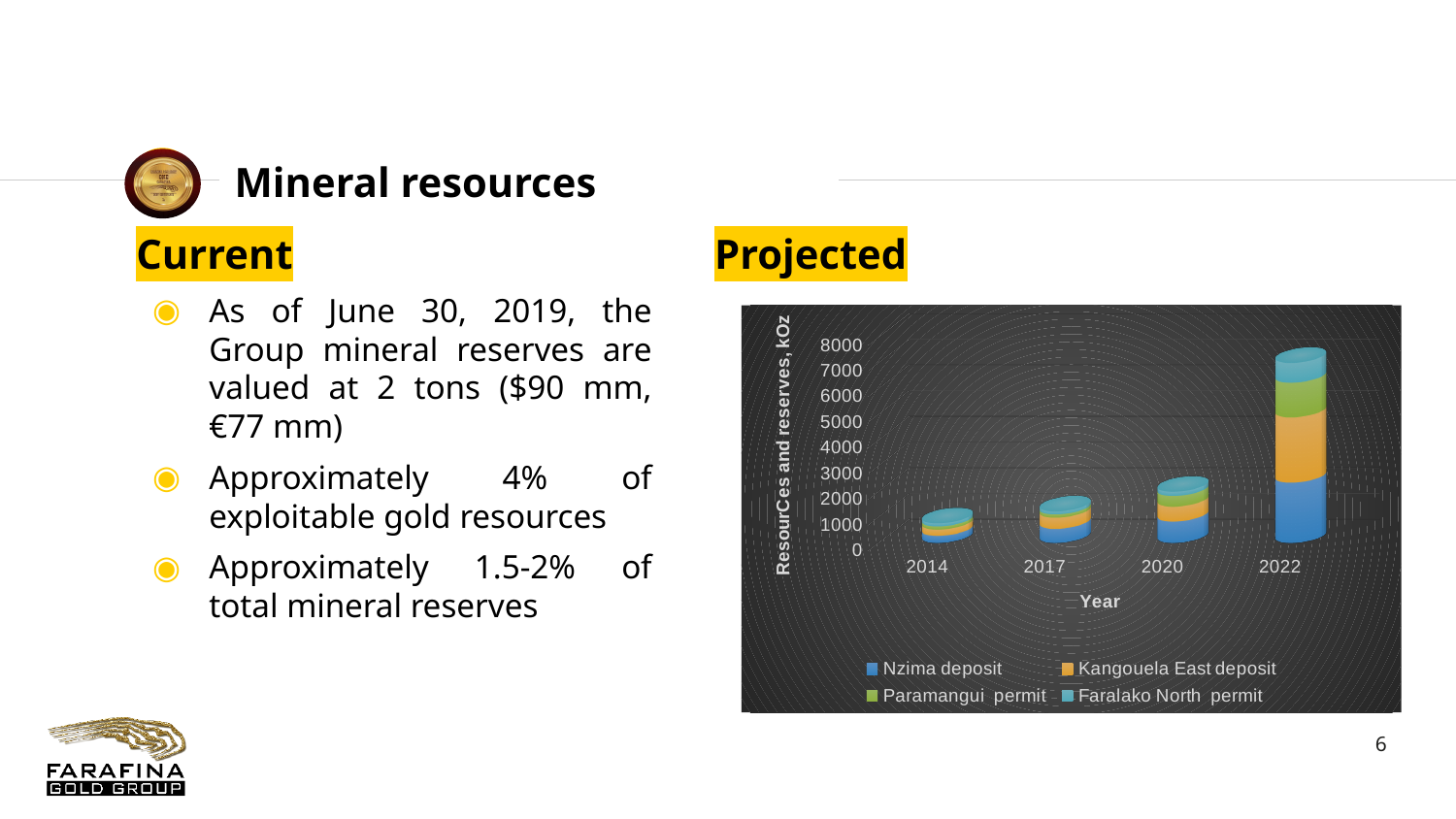
Which year has the shortest stacked bar? 2014 Is the total stacked value for 2022 greater or less than 6000? greater Which year has the larger stacked bar, 2020 or 2022? 2022 What kind of chart is shown on the slide? Stacked bar chart Is the total stacked value for 2014 greater or less than 2000? less Do the stacked bar totals rise or fall from 2014 to 2022? Rise What is the title of the chart's vertical axis? ResourCes and reserves, kOz Which series is shown at the bottom of each stacked bar? Nzima deposit Is the total stacked value for 2020 greater or less than 4000? less Which year has the tallest stacked bar? 2022 How many series does the chart's legend list? 4 How many years are shown on the x axis of the chart? 4